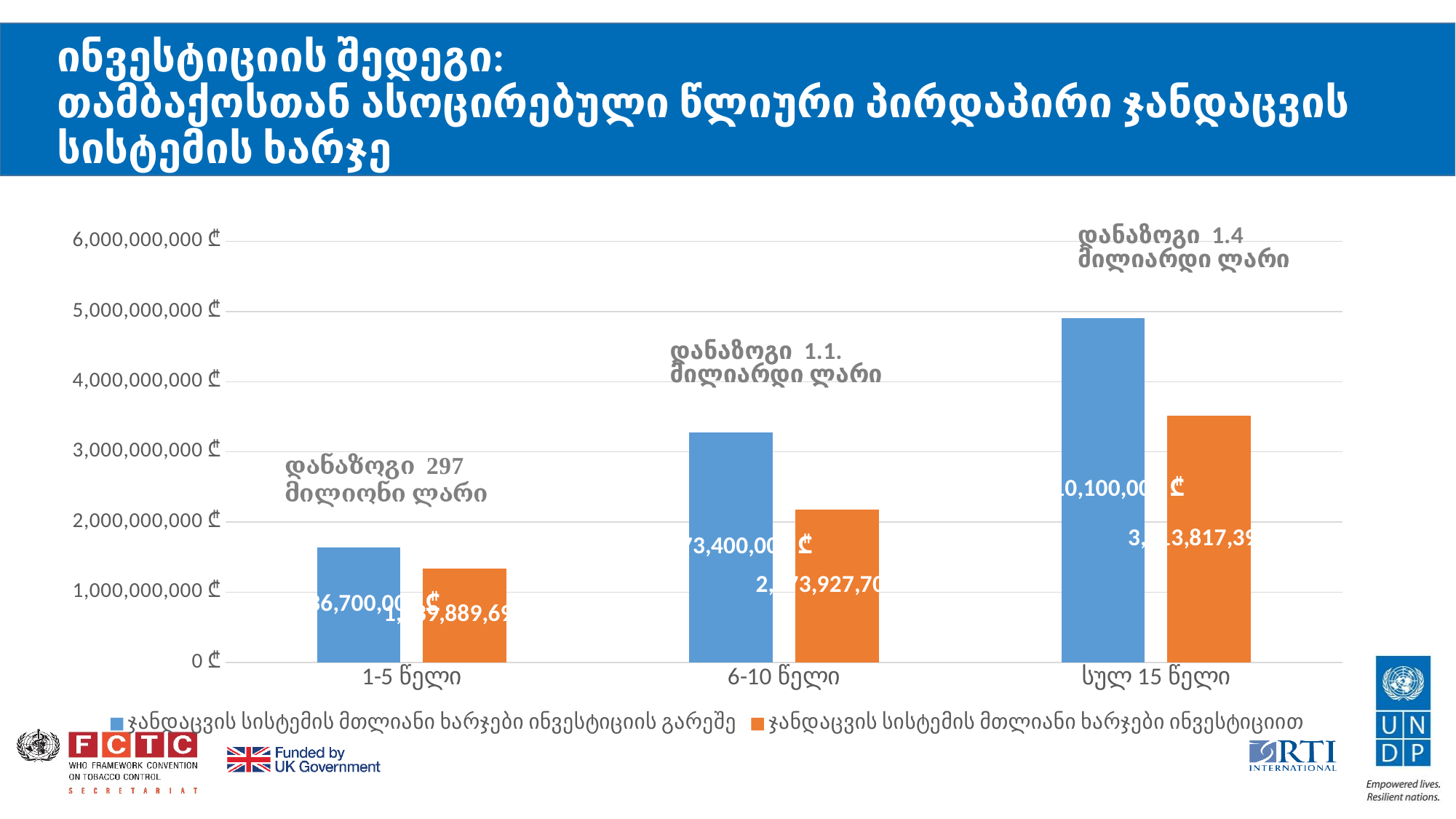
How many series does the chart's legend list? 2 Which category has the lowest orange bar (ჯანდაცვის სისტემის მთლიანი ხარჯები ინვესტიციით)? 1-5 წელი Do the blue bars (ინვესტიციის გარეშე) rise or fall from 1-5 წელი to სულ 15 წელი? rise Is the orange bar (ინვესტიციით) for 1-5 წელი greater or less than 2,000,000,000 ₾? less Which category has the highest blue bar (ჯანდაცვის სისტემის მთლიანი ხარჯები ინვესტიციის გარეშე)? სულ 15 წელი What savings (დანაზოგი) does the annotation above the სულ 15 წელი bars state? 1.4 მილიარდი ლარი What kind of chart is shown on the slide? bar chart How many categories are shown on the x axis of the chart? 3 For the category 6-10 წელი, which bar is larger: the blue one (ინვესტიციის გარეშე) or the orange one (ინვესტიციით)? blue (ინვესტიციის გარეშე) Is the blue bar (ინვესტიციის გარეშე) for სულ 15 წელი greater or less than 4,000,000,000 ₾? greater Is the blue bar (ინვესტიციის გარეშე) for 6-10 წელი greater or less than 3,000,000,000 ₾? greater What savings (დანაზოგი) does the annotation above the 1-5 წელი bars state? 297 მილიონი ლარი